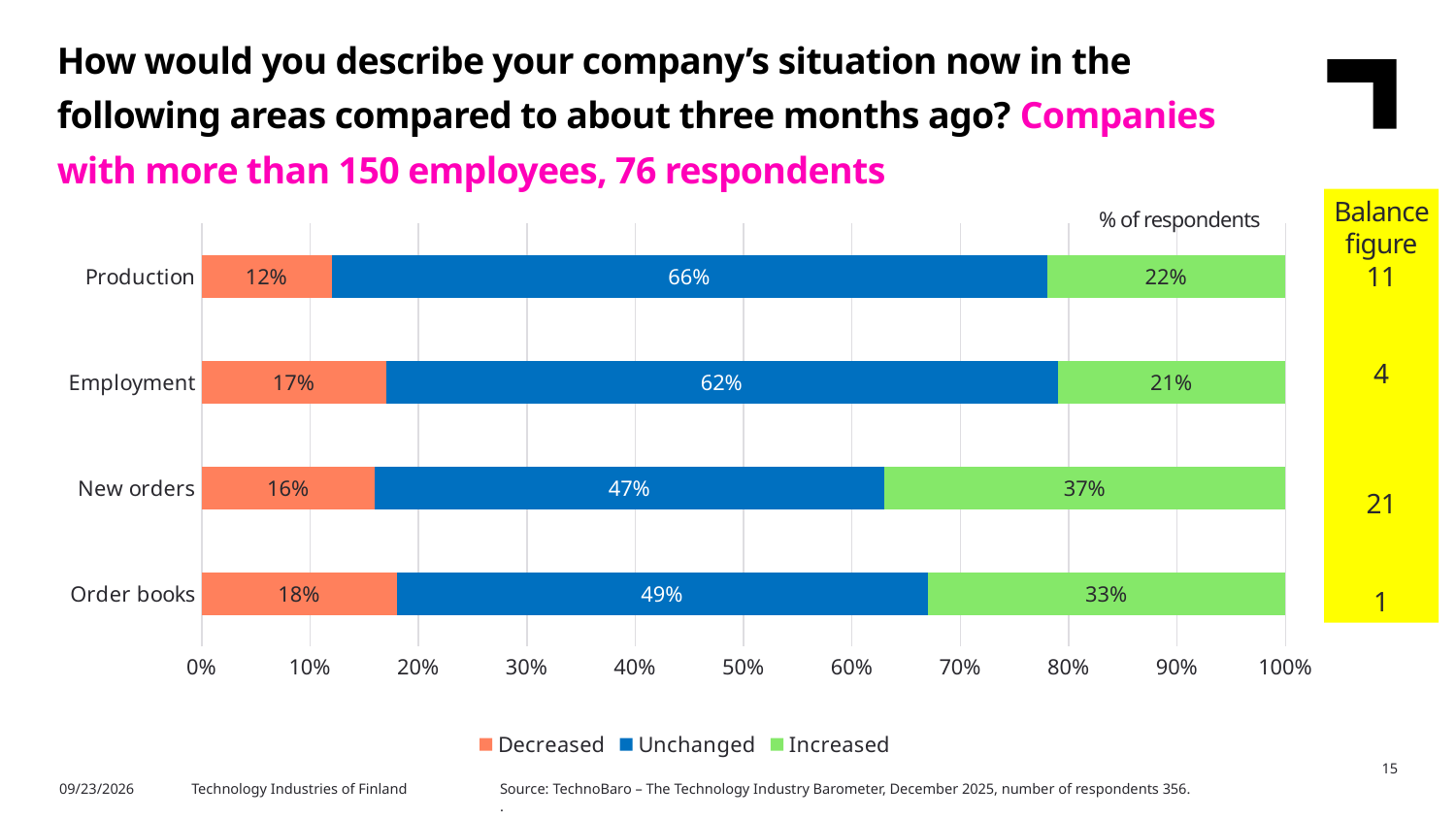
Which category has the highest share of respondents reporting 'Increased'? New orders What percentage of respondents reported that New orders increased? 37% Which is larger: the 'Unchanged' share for Employment or the 'Unchanged' share for Order books? Employment How many series does the legend list? 3 Which category has the lowest share of respondents reporting 'Decreased'? Production What percentage of respondents reported that Production was unchanged? 66% Which colour represents the 'Increased' series in the legend? Green What is the balance figure shown for New orders? 21 What is the difference between the 'Increased' share for New orders and the 'Increased' share for Production? 15% How many categories are shown on the chart? 4 What percentage of respondents reported that Order books decreased? 18% What kind of chart is shown on the slide? Stacked bar chart